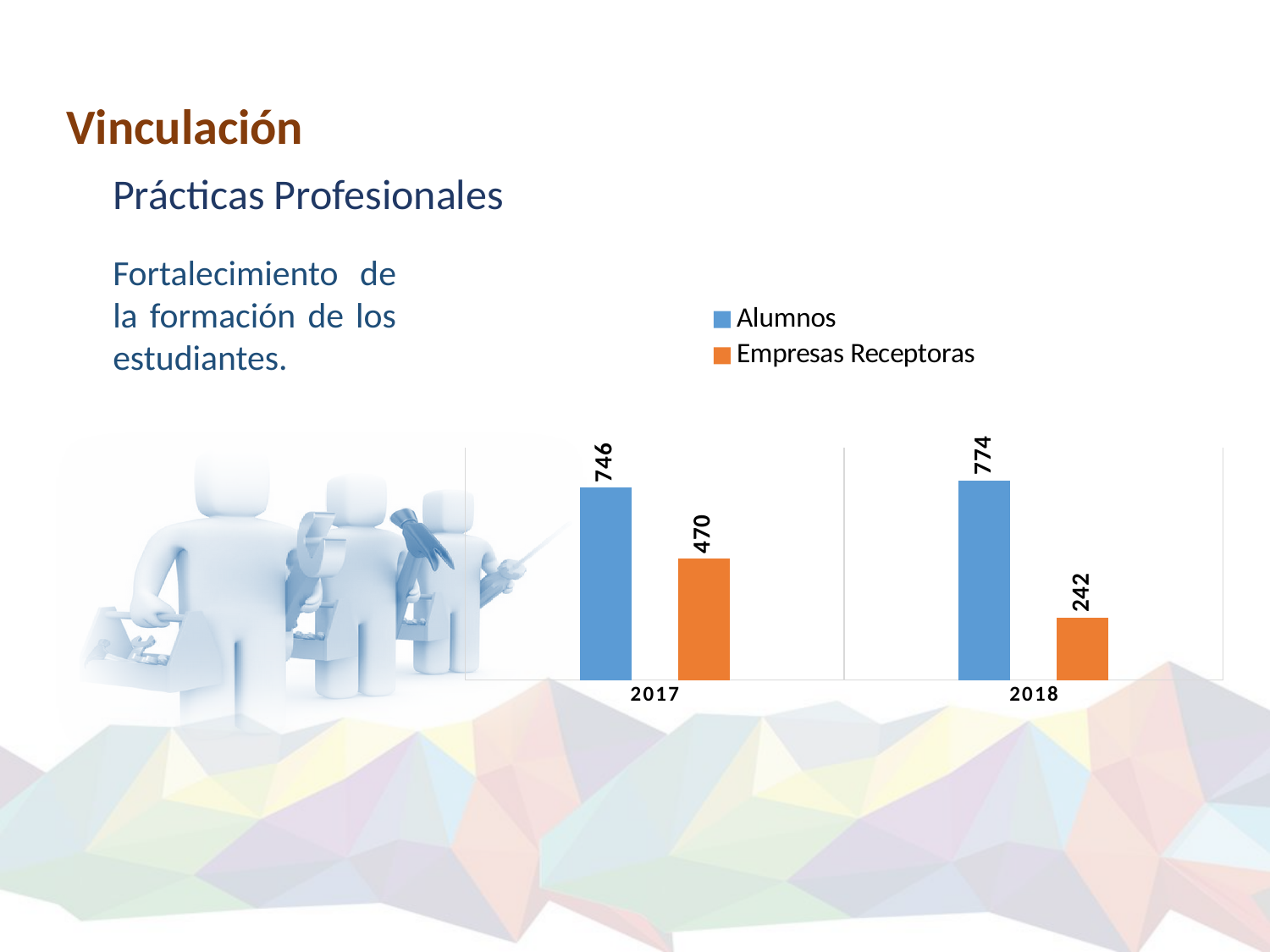
What is the value for Alumnos in 2018? 774 Which is larger in 2018, Alumnos or Empresas Receptoras? Alumnos In which year is the Empresas Receptoras value highest? 2017 How many years are shown on the x axis? 2 What is the value for Empresas Receptoras in 2017? 470 In which year is the Alumnos value lowest? 2017 What is the value for Alumnos in 2017? 746 What is the difference between the Alumnos values for 2018 and 2017? 28 What is the value for Empresas Receptoras in 2018? 242 What is the difference between the Empresas Receptoras values for 2017 and 2018? 228 How many series does the legend list? 2 What kind of chart is shown on the slide? Bar chart